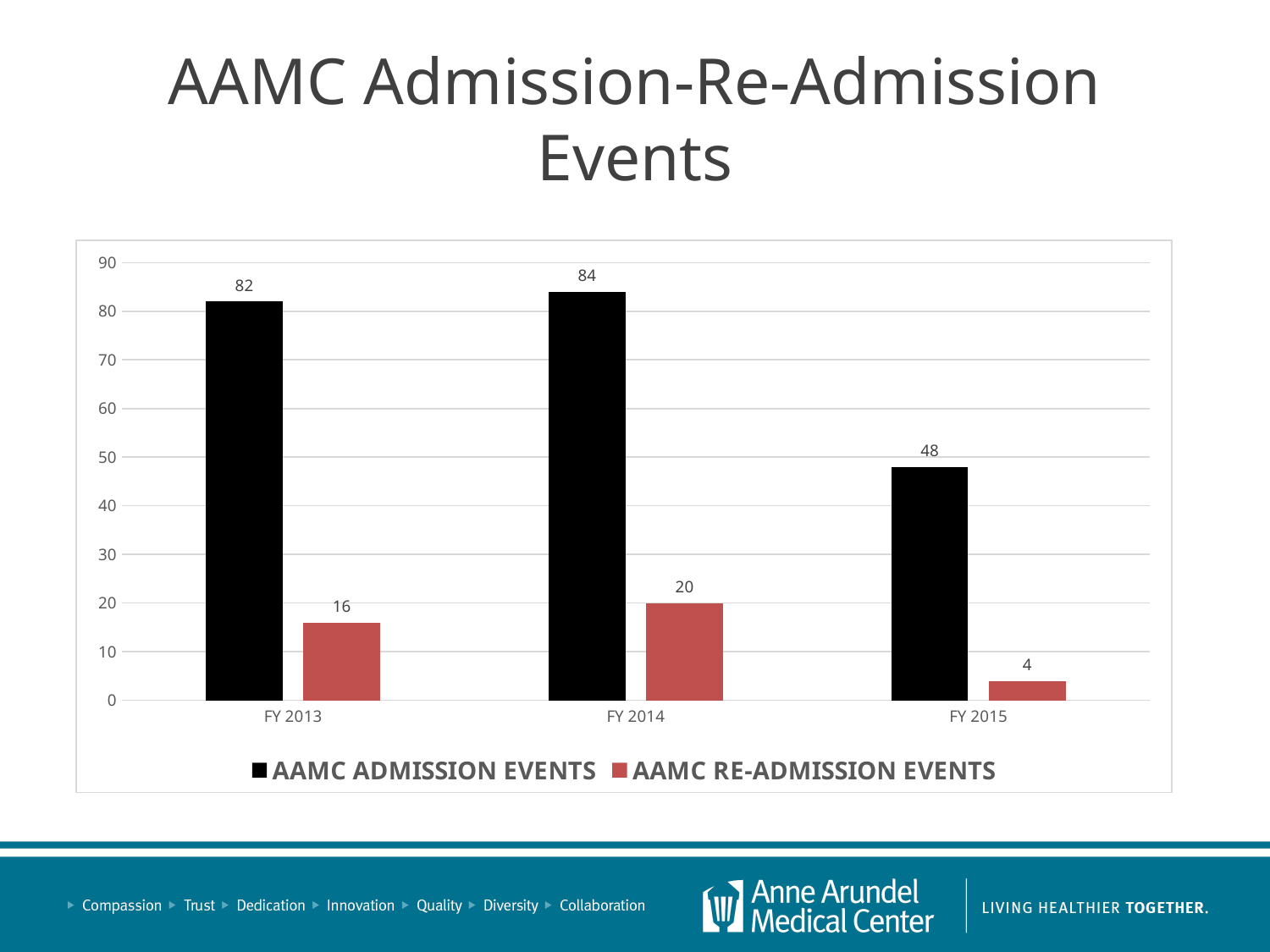
How many series does the legend list? 2 Which is larger: AAMC RE-ADMISSION EVENTS in FY 2013 or in FY 2014? FY 2014 What colour are the bars for AAMC RE-ADMISSION EVENTS? Red What is the value of AAMC ADMISSION EVENTS for FY 2013? 82 How many fiscal years are shown on the x axis? 3 What is the difference in AAMC ADMISSION EVENTS between FY 2014 and FY 2015? 36 What is the difference between AAMC ADMISSION EVENTS and AAMC RE-ADMISSION EVENTS in FY 2015? 44 What kind of chart is shown on the slide? Bar chart What is the value of AAMC RE-ADMISSION EVENTS for FY 2015? 4 What is the value of AAMC RE-ADMISSION EVENTS for FY 2014? 20 Which fiscal year has the lowest value for AAMC RE-ADMISSION EVENTS? FY 2015 Which fiscal year has the highest value for AAMC ADMISSION EVENTS? FY 2014